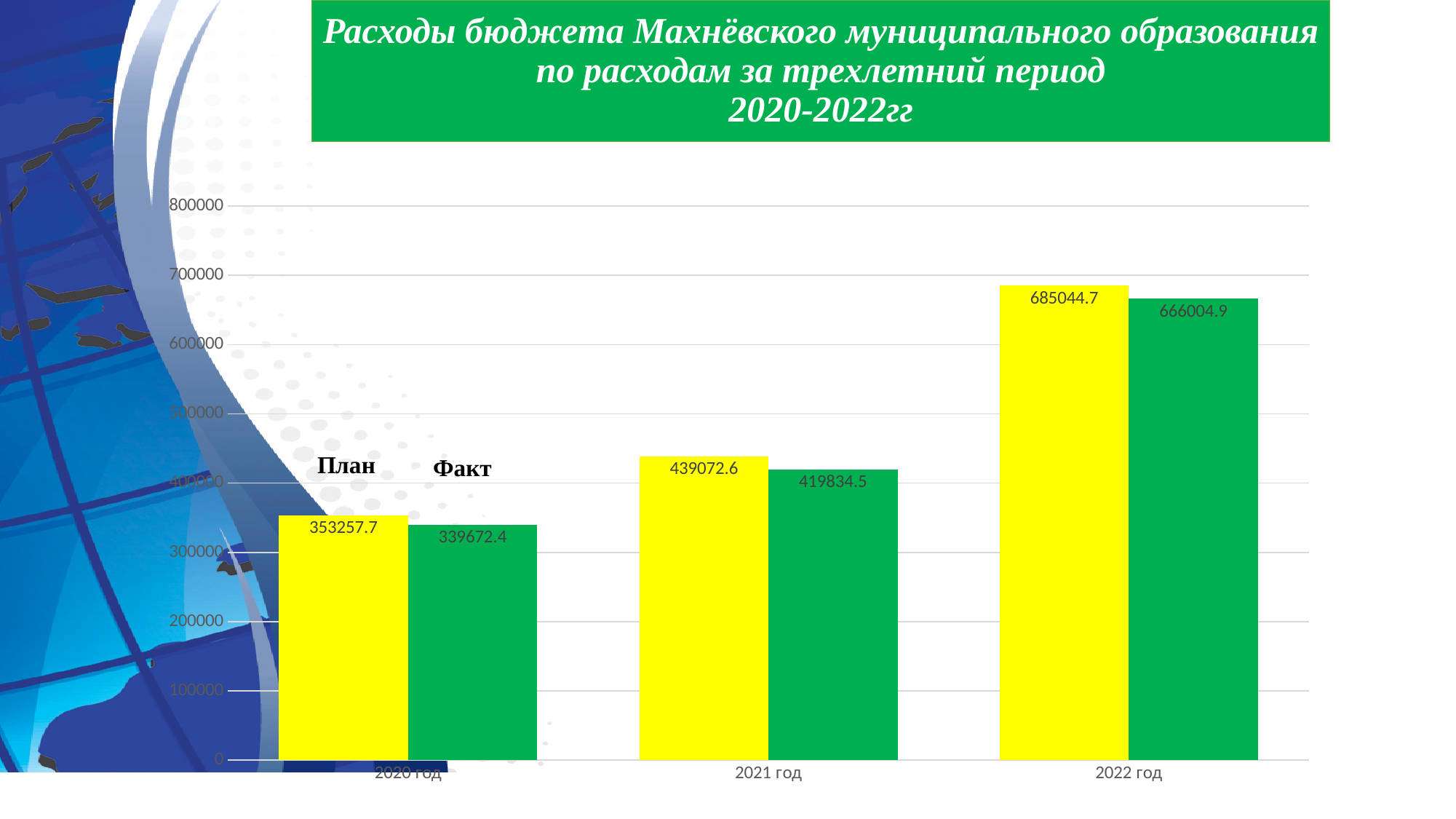
Which is larger for 2021 год, the План value or the Факт value? План Which year has the lowest Факт value? 2020 год What is the Факт value for 2022 год? 666004.9 How many years are shown on the x axis? 3 What is the difference between the План and Факт values for 2022 год? 19039.8 What is the difference between the План and Факт values for 2020 год? 13585.3 What is the План value for 2021 год? 439072.6 What is the Факт value for 2020 год? 339672.4 Do the Факт values rise or fall from 2020 год to 2022 год? Rise What kind of chart is shown on the slide? Bar chart How many series does the chart show? 2 Which year has the highest План value? 2022 год